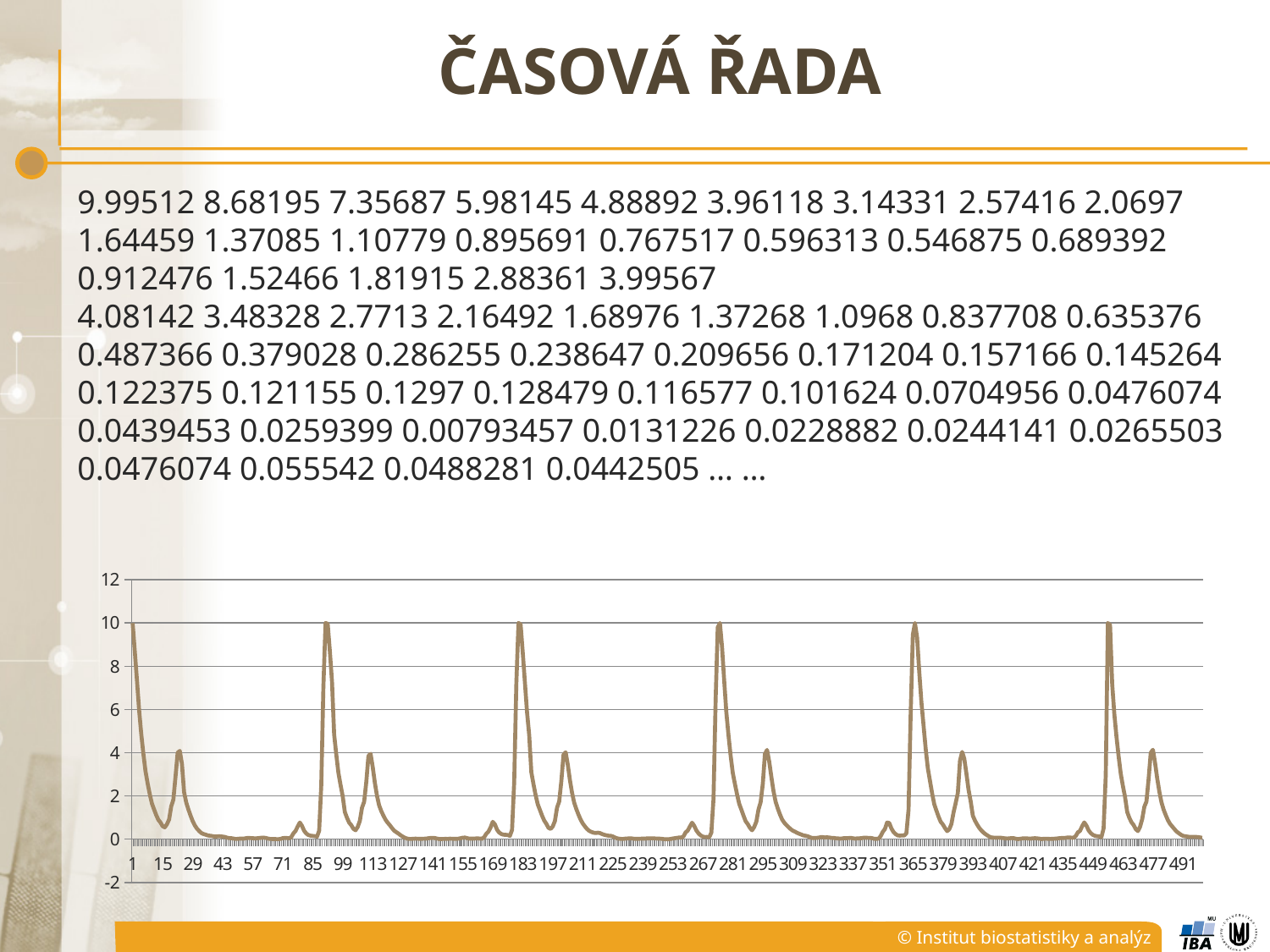
How many lines (series) are plotted on the chart? 1 Which has the larger value, x = 1 or x = 15? 1 Is the value at x = 1 greater or less than 8? greater Is the value at x = 43 greater or less than 2? less What is the title of the slide containing the chart? ČASOVÁ ŘADA Is the value at x = 141 greater or less than 4? less Between x = 1 and x = 15, does the line rise or fall? fall What is the highest tick value shown on the y axis? 12 How many times does the line reach the 10 gridline? 6 What kind of chart is shown on the slide? line chart